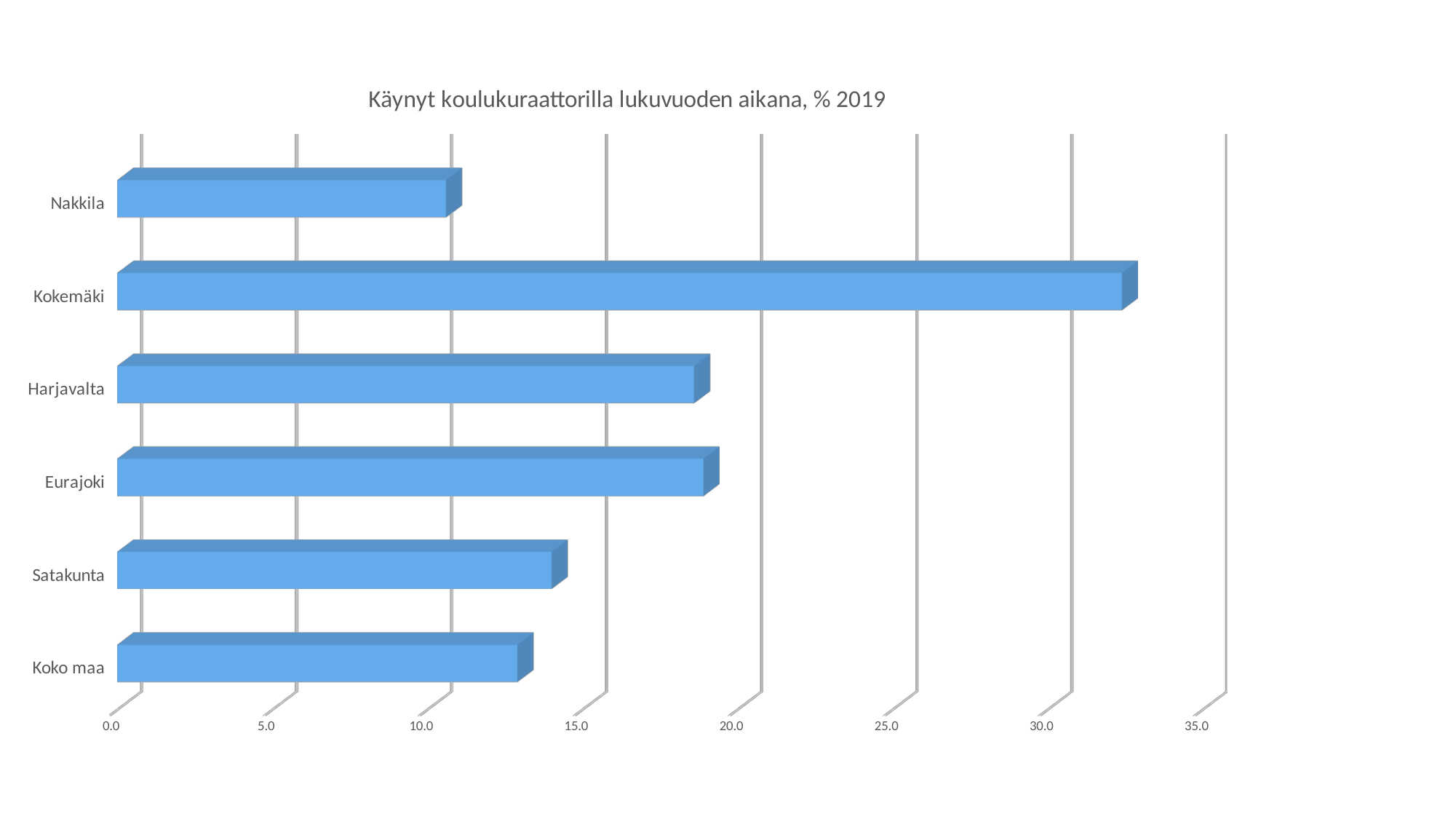
Which is larger, the value for Kokemäki or the value for Harjavalta? Kokemäki Is the value for Nakkila greater or less than 15.0? less Which category has the lowest value? Nakkila Is the value for Harjavalta greater or less than 20.0? less What is the title of the chart? Käynyt koulukuraattorilla lukuvuoden aikana, % 2019 Is the value for Satakunta greater or less than 15.0? less What kind of chart is shown on the slide? Bar chart Which category has the highest value? Kokemäki How many categories are shown in the chart? 6